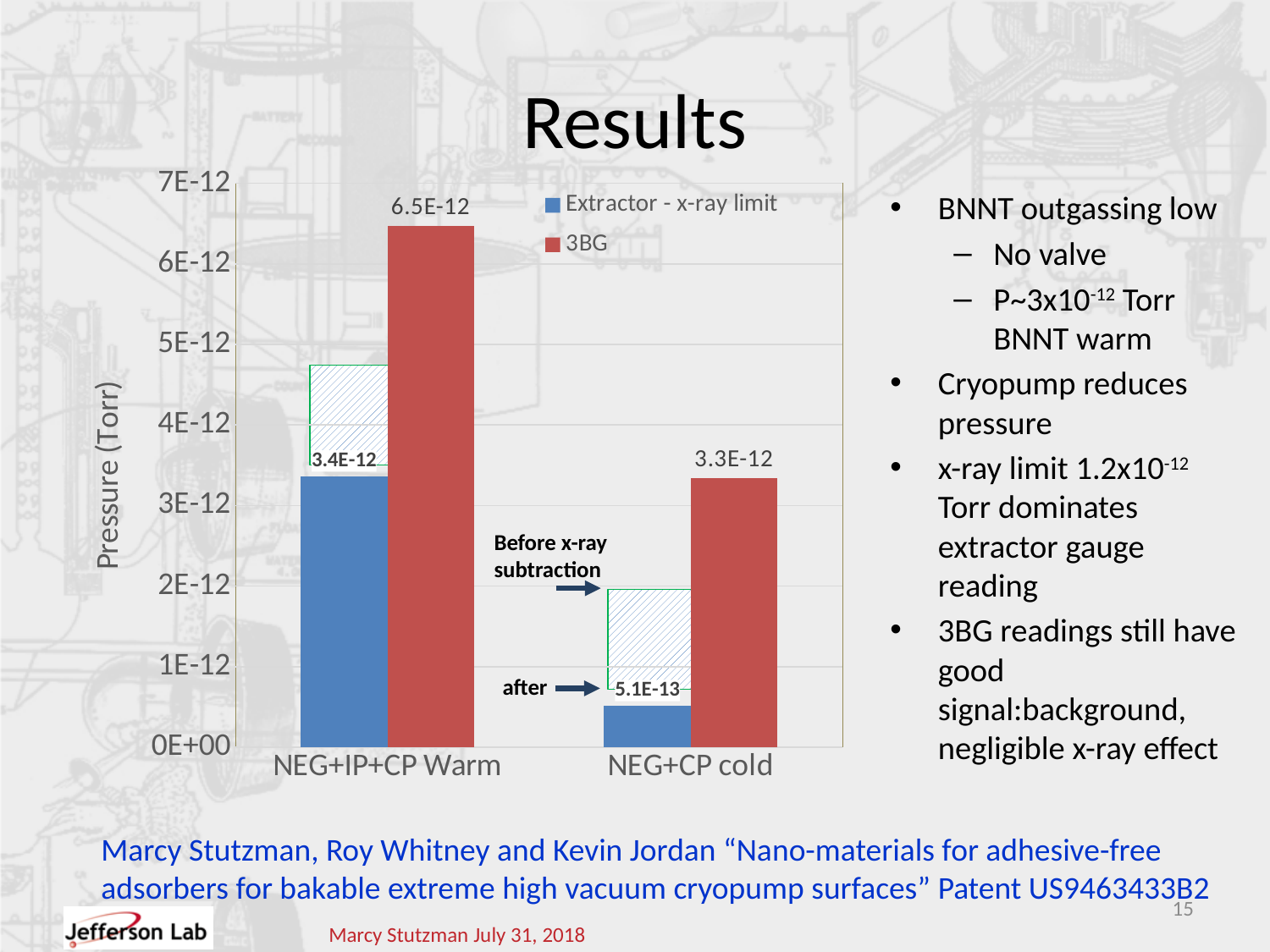
Which category has the lowest Extractor - x-ray limit value? NEG+CP cold What is the difference between the 3BG value and the Extractor - x-ray limit value for NEG+IP+CP Warm? 3.1E-12 How many categories are shown on the x axis of the chart? 2 How many series does the chart legend list? 2 What is the 3BG value for NEG+CP cold? 3.3E-12 Which is larger for NEG+CP cold: the 3BG value or the Extractor - x-ray limit value? 3BG Which category has the highest 3BG value? NEG+IP+CP Warm What is the Extractor - x-ray limit value for NEG+CP cold? 5.1E-13 What is the label of the y axis of the chart? Pressure (Torr) What type of chart is shown on the slide? bar chart What is the Extractor - x-ray limit value for NEG+IP+CP Warm? 3.4E-12 What is the 3BG value for NEG+IP+CP Warm? 6.5E-12